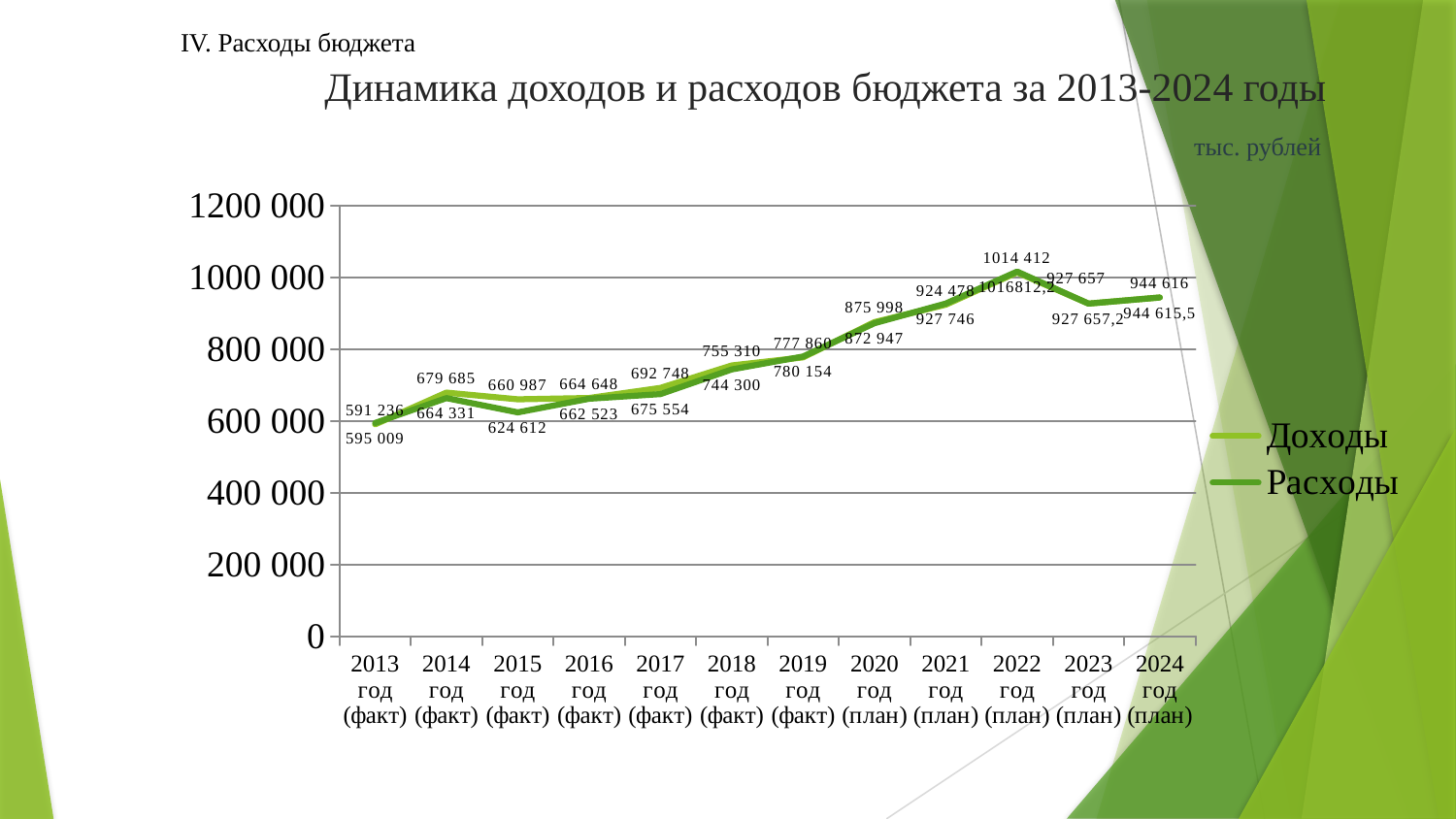
How many years (categories) are plotted on the x axis? 12 How many series does the legend list? 2 What is the difference between Доходы in 2022 год (план) and 2023 год (план)? 86 755 By how much did Доходы increase from 2013 год (факт) to 2014 год (факт)? 88 449 In which year is the value of Расходы the lowest? 2013 год (факт) What is the value of Расходы for 2015 год (факт)? 624 612 In 2015 год (факт), which is larger: Доходы or Расходы? Доходы What unit of measurement is indicated for the chart values? тыс. рублей What is the value of Доходы for 2018 год (факт)? 755 310 What type of chart is shown on the slide? Line chart In which year is the value of Доходы the highest? 2022 год (план) Is the value of Доходы for 2020 год (план) greater or less than 800 000? greater